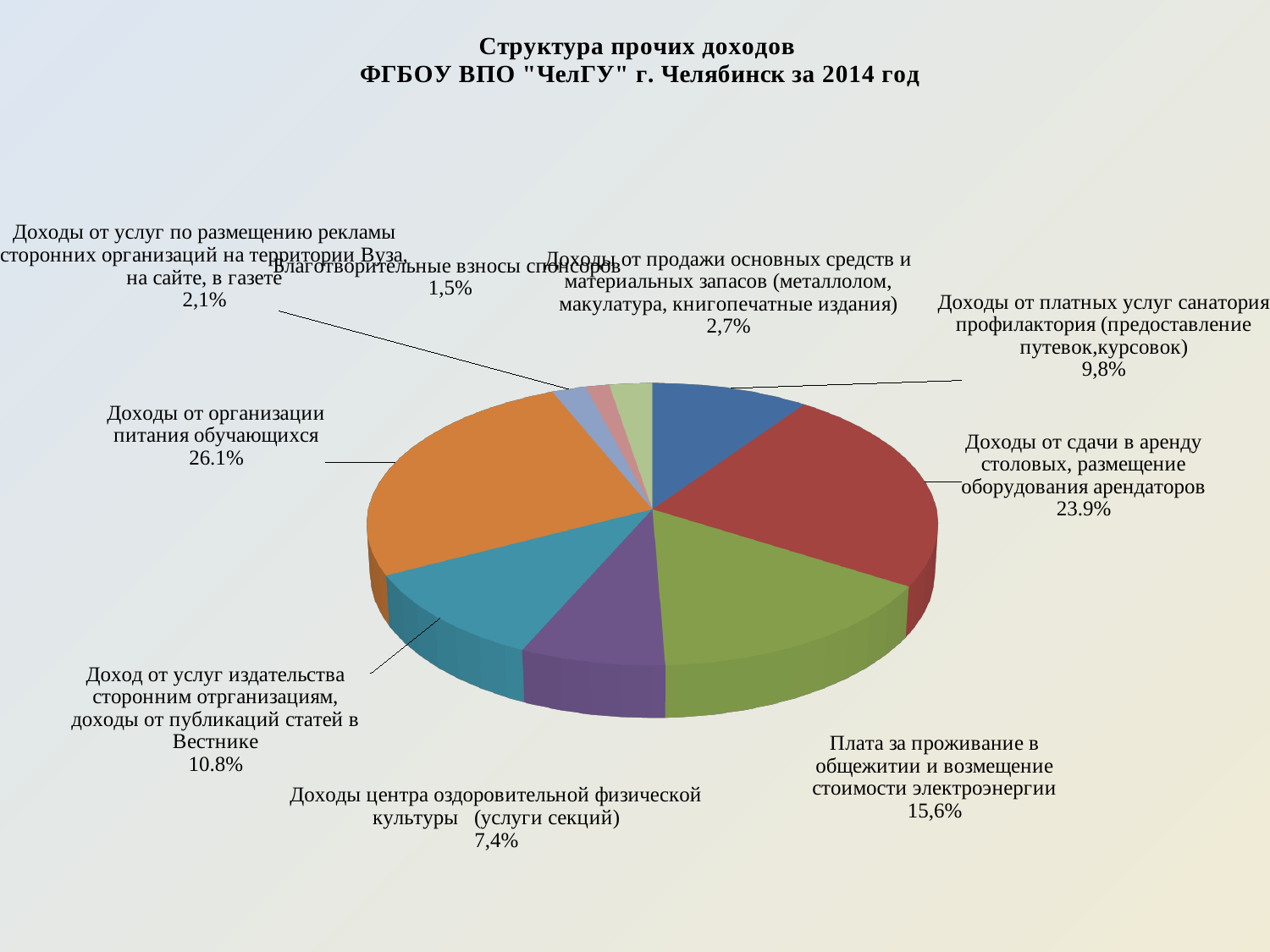
Which category has the largest share of the pie? Доходы от организации питания обучающихся What year does the chart title say the data is for? 2014 What share is shown for "Доходы от продажи основных средств и материальных запасов (металлолом, макулатура, книгопечатные издания)"? 2,7% What share is shown for "Плата за проживание в общежитии и возмещение стоимости электроэнергии"? 15,6% What share is shown for "Доходы центра оздоровительной физической культуры (услуги секций)"? 7,4% Which is larger: the share for "Доход от услуг издательства сторонним организациям, доходы от публикаций статей в Вестнике" or the share for "Доходы от платных услуг санатория профилактория"? Доход от услуг издательства сторонним организациям, доходы от публикаций статей в Вестнике How many slices does the pie chart have? 9 What share is shown for "Доходы от сдачи в аренду столовых, размещение оборудования арендаторов"? 23.9% Which category has the smallest share of the pie? Благотворительные взносы спонсоров What kind of chart is shown on the slide? pie chart What share is shown for "Доходы от платных услуг санатория профилактория (предоставление путевок, курсовок)"? 9,8% By how many percentage points does the share for "Доходы от организации питания обучающихся" exceed the share for "Доходы от сдачи в аренду столовых, размещение оборудования арендаторов"? 2.2%